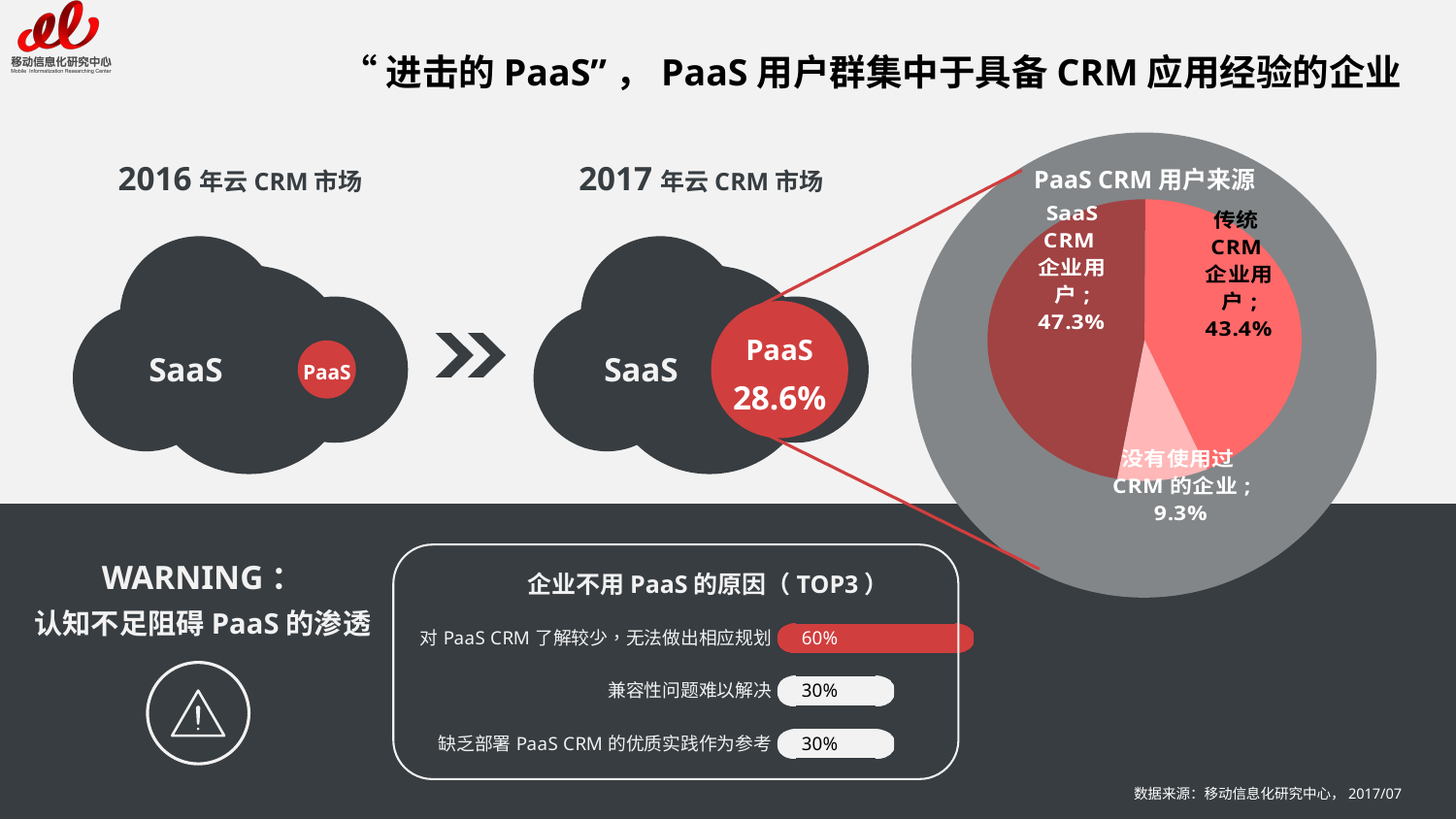
In the pie chart 'PaaS CRM 用户来源', what share is labelled for SaaS CRM 企业用户? 47.3% In the pie chart 'PaaS CRM 用户来源', what is the difference between the shares of SaaS CRM 企业用户 and 传统 CRM 企业用户? 3.9% In the chart '企业不用 PaaS 的原因（TOP3）', what is the value for 兼容性问题难以解决? 30% What kind of chart is '企业不用 PaaS 的原因（TOP3）'? Bar chart What kind of chart is 'PaaS CRM 用户来源'? Pie chart In the pie chart 'PaaS CRM 用户来源', what share is labelled for 传统 CRM 企业用户? 43.4% In the pie chart 'PaaS CRM 用户来源', what share is labelled for 没有使用过 CRM 的企业? 9.3% In the pie chart 'PaaS CRM 用户来源', which category has the largest share? SaaS CRM 企业用户 In the pie chart 'PaaS CRM 用户来源', how many slices are there? 3 In the chart '企业不用 PaaS 的原因（TOP3）', what is the value for 对 PaaS CRM 了解较少，无法做出相应规划? 60% In the pie chart 'PaaS CRM 用户来源', which category has the smallest share? 没有使用过 CRM 的企业 In the chart '企业不用 PaaS 的原因（TOP3）', which reason has the highest value? 对 PaaS CRM 了解较少，无法做出相应规划